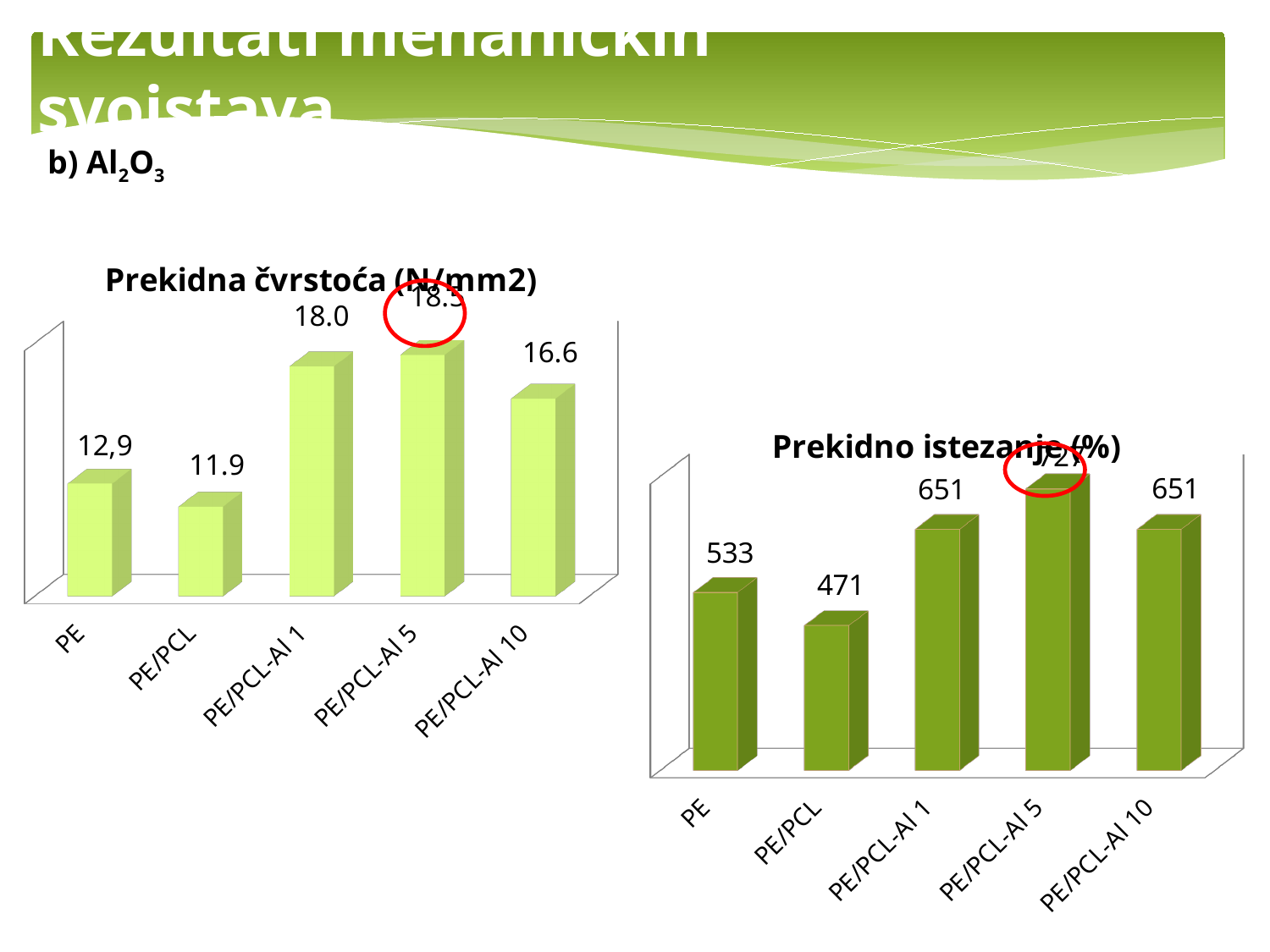
In the chart titled "Prekidna čvrstoća (N/mm2)", what is the value for PE/PCL-Al 1? 18.0 In the chart titled "Prekidno istezanje (%)", what is the value for PE? 533 In the chart titled "Prekidno istezanje (%)", what is the value for PE/PCL-Al 10? 651 In the chart titled "Prekidno istezanje (%)", which category has the lowest value? PE/PCL In the chart titled "Prekidna čvrstoća (N/mm2)", what is the value for PE/PCL-Al 10? 16.6 In the chart titled "Prekidna čvrstoća (N/mm2)", what is the difference between the values for PE/PCL-Al 1 and PE/PCL? 6.1 In the chart titled "Prekidna čvrstoća (N/mm2)", which category has the lowest value? PE/PCL In the chart titled "Prekidna čvrstoća (N/mm2)", what is the value for PE/PCL? 11.9 In the chart titled "Prekidno istezanje (%)", which category has the highest value? PE/PCL-Al 5 How many categories are shown in the chart titled "Prekidno istezanje (%)"? 5 In the chart titled "Prekidno istezanje (%)", which is larger, the value for PE/PCL-Al 1 or the value for PE? PE/PCL-Al 1 In the chart titled "Prekidno istezanje (%)", what is the difference between the values for PE and PE/PCL? 62